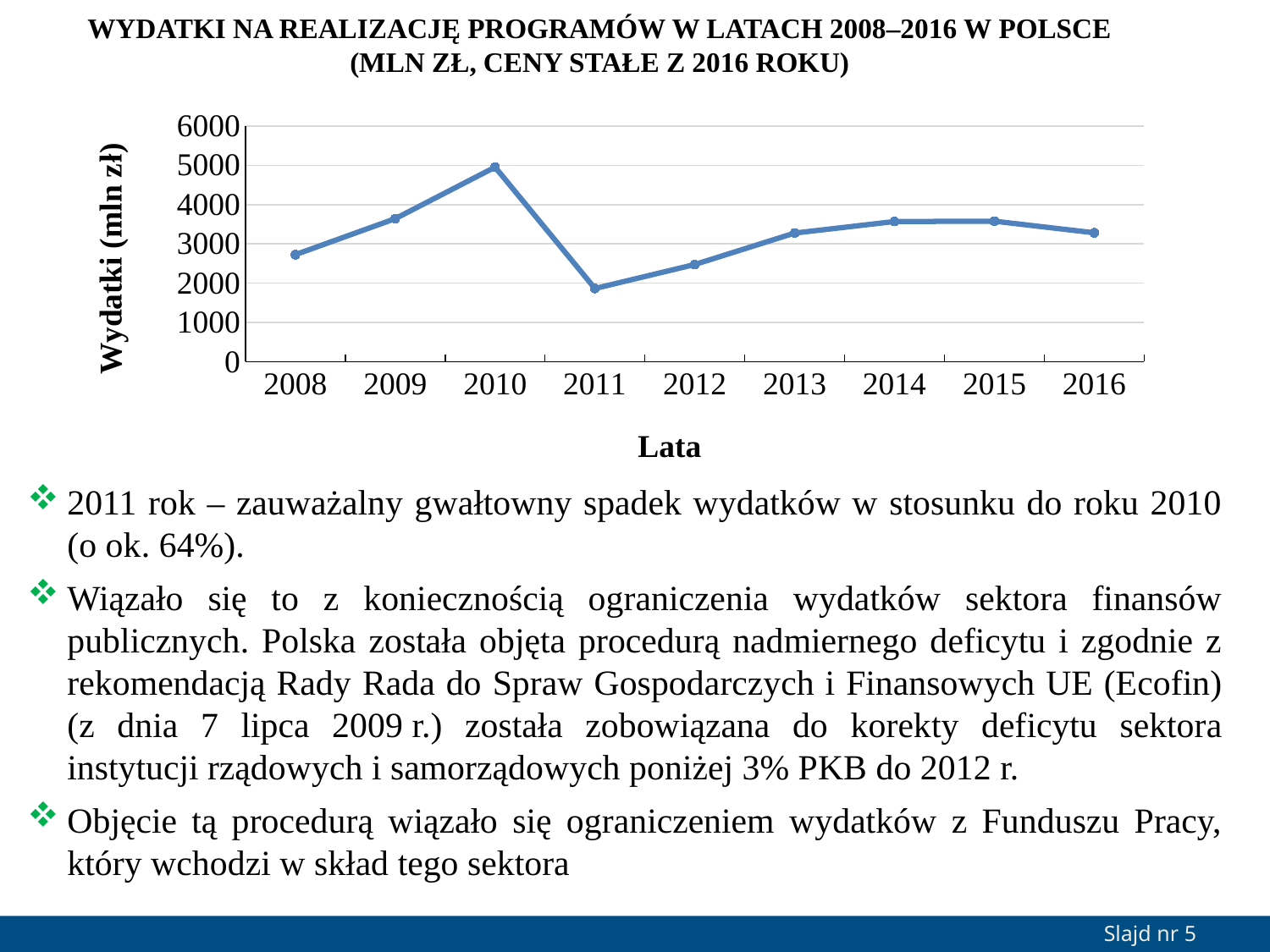
How many years are plotted on the x axis of the chart? 9 What is the label of the vertical axis of the chart? Wydatki (mln zł) Is the value for 2014 greater or less than 3000? greater What is the label of the horizontal axis of the chart? Lata In which year were the expenditures (Wydatki) lowest? 2011 Is the value for 2011 greater or less than 2000? less Which year has the larger value, 2009 or 2012? 2009 Is the value for 2008 greater or less than 3000? less In which year were the expenditures (Wydatki) highest? 2010 Do the values rise or fall from 2011 to 2014? rise What kind of chart is shown on the slide? line chart